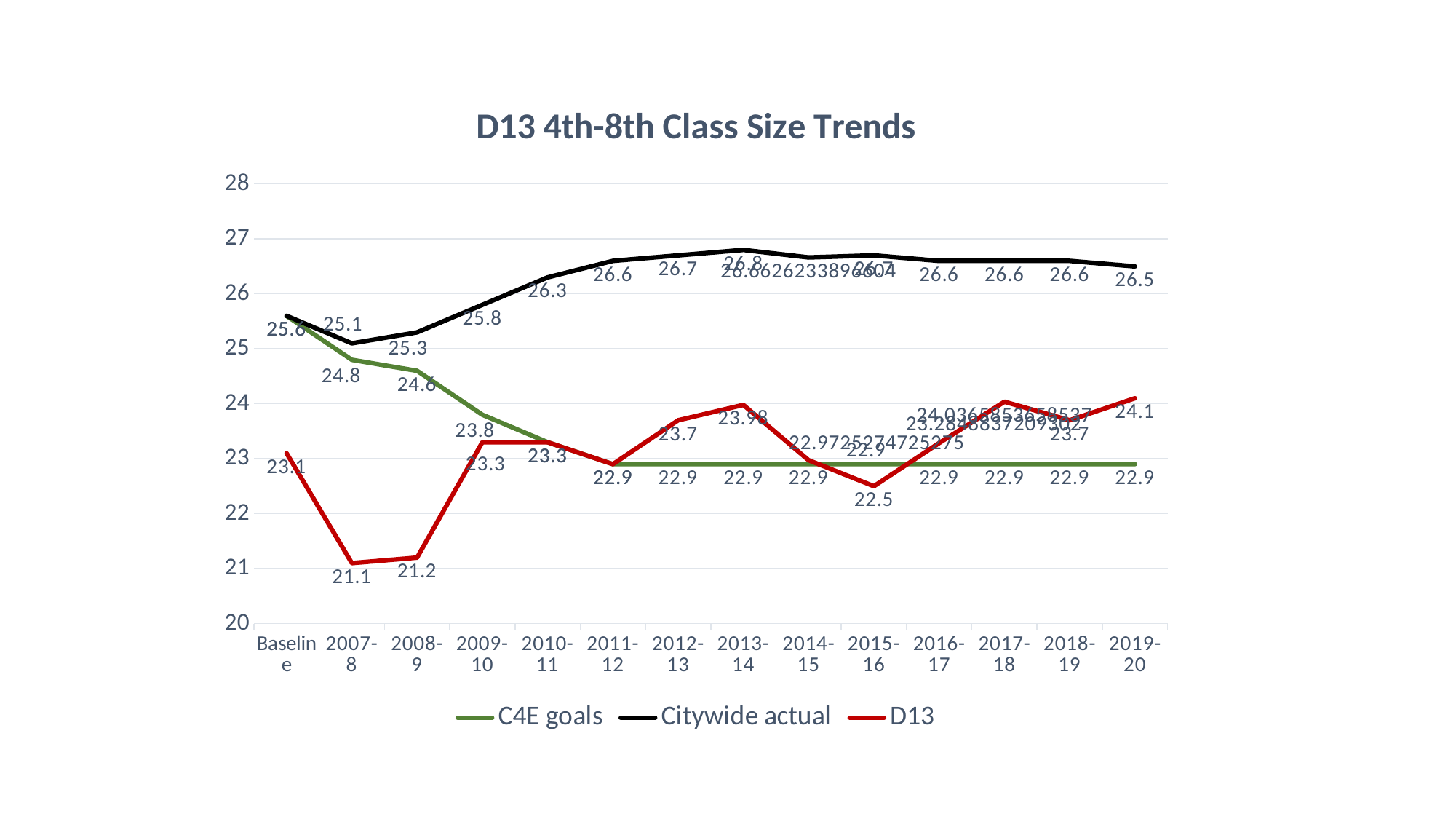
What is the Citywide actual value for 2019-20? 26.5 In 2019-20, which is larger: the D13 value or the C4E goals value? D13 How many categories are shown on the x axis? 14 What kind of chart is shown on the slide? line chart What is the difference between the Citywide actual and D13 values in 2019-20? 2.4 What is the D13 value for 2015-16? 22.5 Does the C4E goals series rise or fall from Baseline to 2019-20? fall What is the D13 value for 2007-8? 21.1 What is the C4E goals value for 2008-9? 24.6 How many series does the legend list? 3 In which year is the Citywide actual value highest? 2013-14 In which year is the D13 value lowest? 2007-8